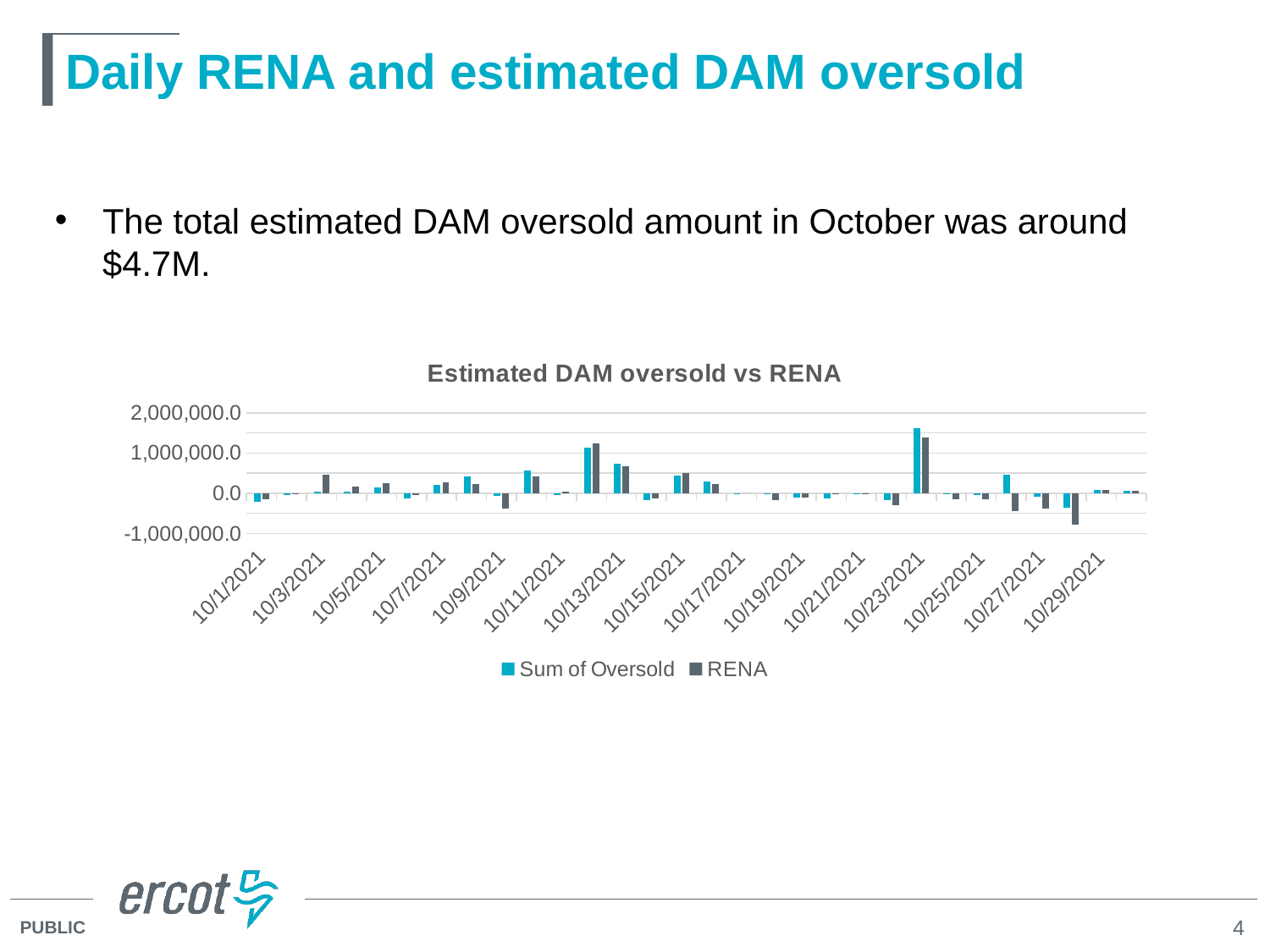
What are the two series named in the chart legend? Sum of Oversold and RENA Is the RENA value for 10/23/2021 greater or less than 1,000,000.0? greater Is the Sum of Oversold value for 10/23/2021 greater or less than 1,000,000.0? greater Is the RENA value for 10/3/2021 greater or less than 1,000,000.0? less What is the title of the chart? Estimated DAM oversold vs RENA On which date does the Sum of Oversold series reach its highest value? 10/23/2021 Which date has the larger Sum of Oversold value, 10/13/2021 or 10/23/2021? 10/23/2021 How many series does the legend of the chart list? 2 On 10/23/2021, which series has the larger value, Sum of Oversold or RENA? Sum of Oversold How many date labels are printed along the x axis of the chart? 15 What kind of chart is shown on the slide? Bar chart